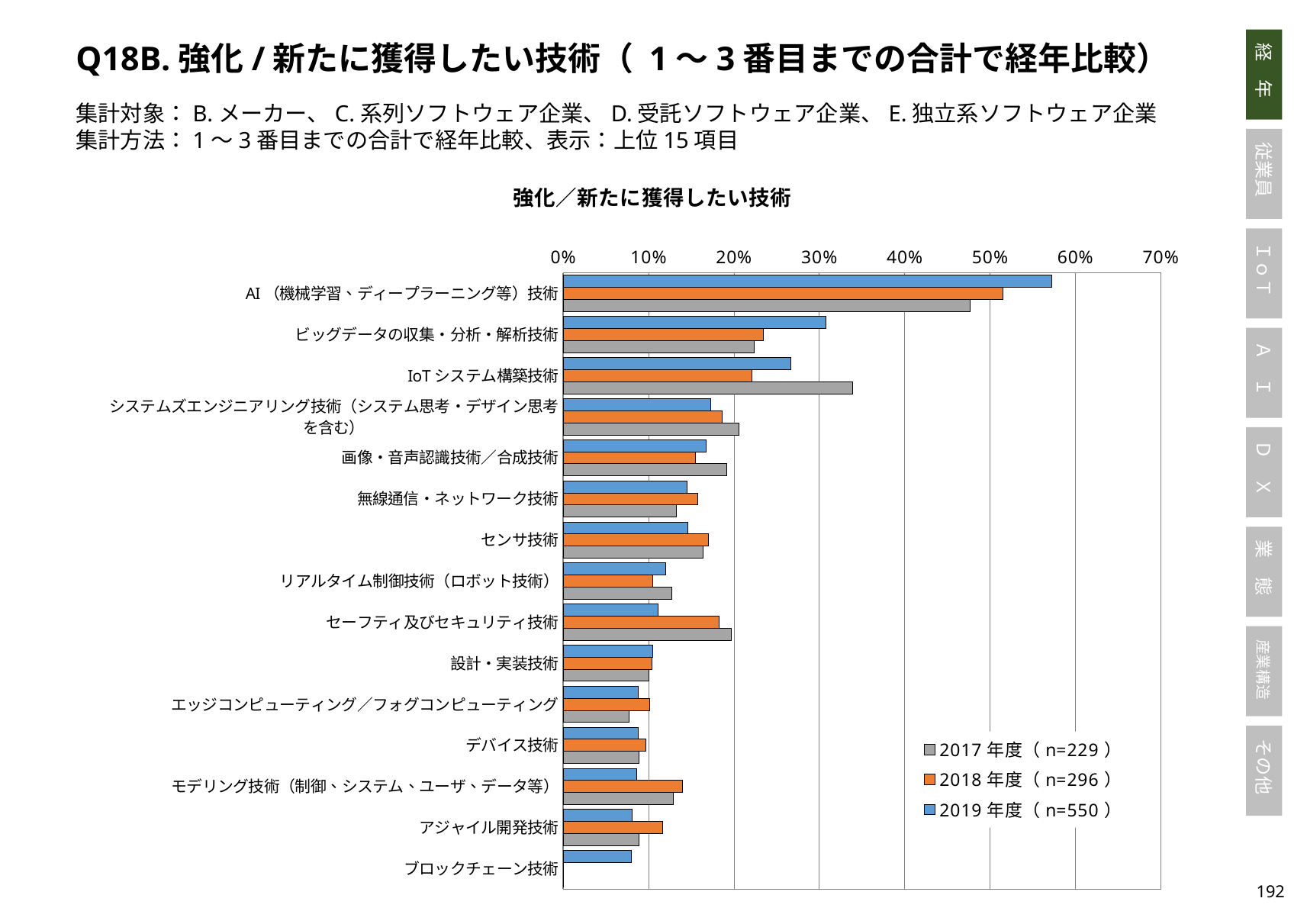
Which category has the highest value for the 2019年度 series? AI（機械学習、ディープラーニング等）技術 Is the 2019年度 value for ブロックチェーン技術 greater or less than 10%? less Is the 2019年度 value for AI（機械学習、ディープラーニング等）技術 greater or less than 50%? greater How many series does the legend list? 3 Is the 2017年度 value for IoTシステム構築技術 greater or less than 30%? greater For AI（機械学習、ディープラーニング等）技術, which is larger: the 2018年度 value or the 2019年度 value? 2019年度 Which category has the highest value for the 2017年度 series? AI（機械学習、ディープラーニング等）技術 What sample size (n) does the legend give for the 2019年度 series? n=550 For IoTシステム構築技術, which is larger: the 2017年度 value or the 2019年度 value? 2017年度 How many technology categories are listed on the chart? 15 What kind of chart is shown on the slide? bar chart